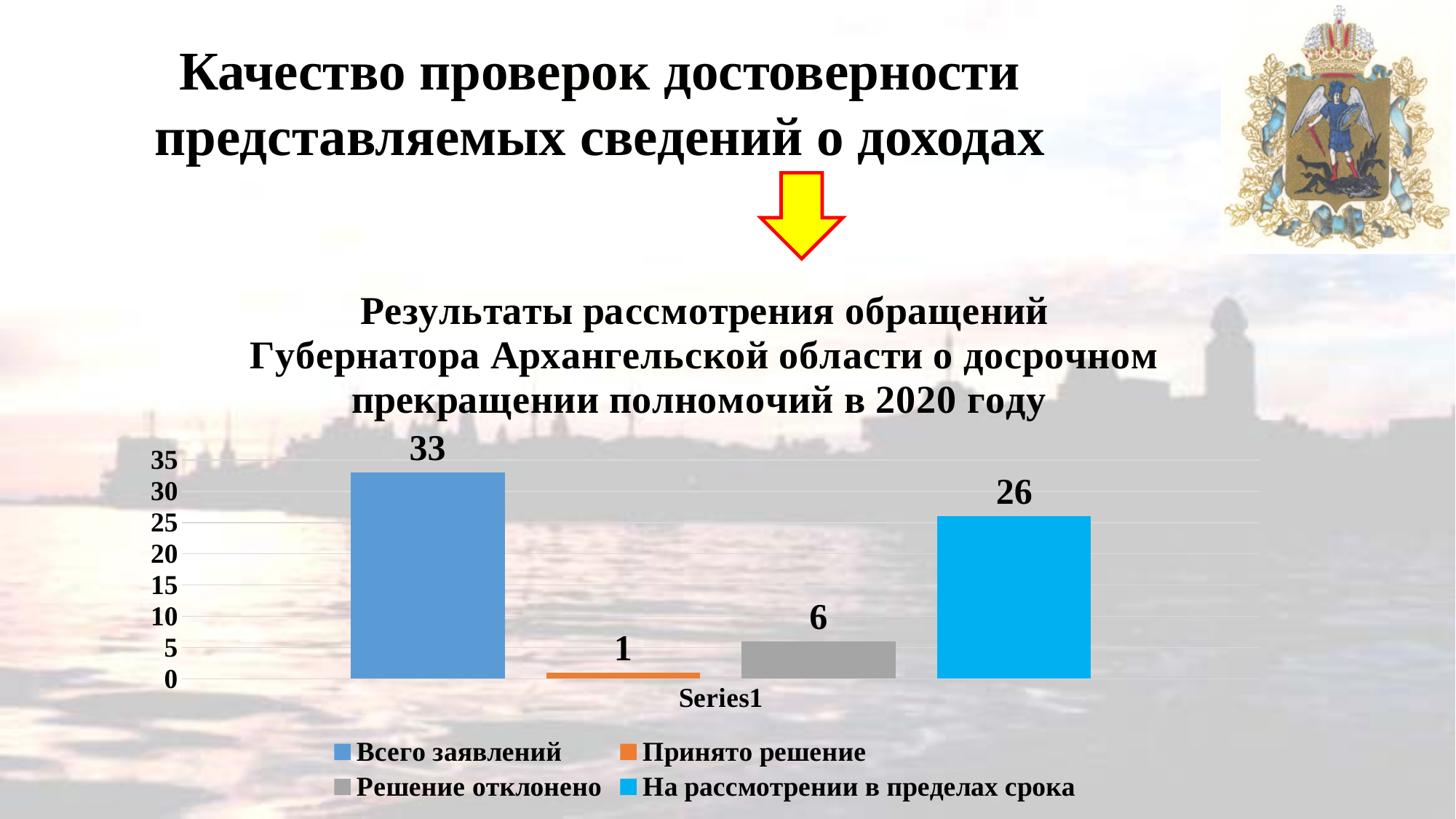
What is the difference between "Всего заявлений" and "На рассмотрении в пределах срока"? 7 What is the value for "Принято решение"? 1 What is the label shown on the x axis under the bars? Series1 What is the value for "На рассмотрении в пределах срока"? 26 What kind of chart is shown on the slide? bar chart What is the value for "Решение отклонено"? 6 What is the value for "Всего заявлений"? 33 Is the value for "На рассмотрении в пределах срока" greater or less than 25? greater How many series does the legend list? 4 Which series has the highest value? Всего заявлений Which series has the lowest value? Принято решение Which is larger, "Решение отклонено" or "На рассмотрении в пределах срока"? На рассмотрении в пределах срока